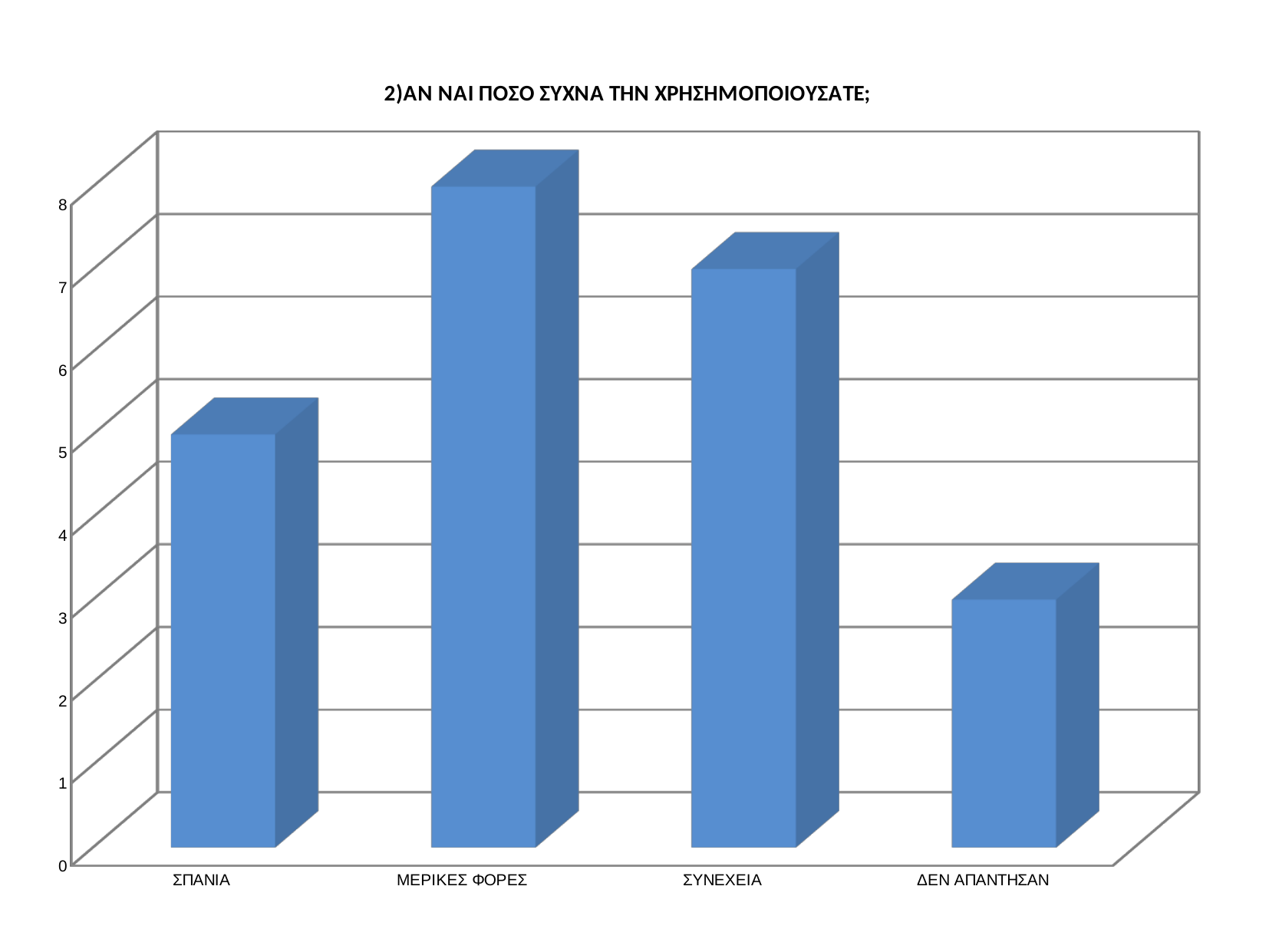
Which is larger, the value for ΣΠΑΝΙΑ or the value for ΔΕΝ ΑΠΑΝΤΗΣΑΝ? ΣΠΑΝΙΑ Is the value for ΣΠΑΝΙΑ greater or less than 7? less How many categories are shown on the x axis? 4 What is the title of the chart? 2)ΑΝ ΝΑΙ ΠΟΣΟ ΣΥΧΝΑ ΤΗΝ ΧΡΗΣΗΜΟΠΟΙΟΥΣΑΤΕ; Which is larger, the value for ΜΕΡΙΚΕΣ ΦΟΡΕΣ or the value for ΣΥΝΕΧΕΙΑ? ΜΕΡΙΚΕΣ ΦΟΡΕΣ What kind of chart is shown on the slide? Bar chart Is the value for ΔΕΝ ΑΠΑΝΤΗΣΑΝ greater or less than 5? less Which category has the lowest bar? ΔΕΝ ΑΠΑΝΤΗΣΑΝ Which category has the highest bar? ΜΕΡΙΚΕΣ ΦΟΡΕΣ Is the value for ΜΕΡΙΚΕΣ ΦΟΡΕΣ greater or less than 6? greater What colour are the bars in the chart? Blue